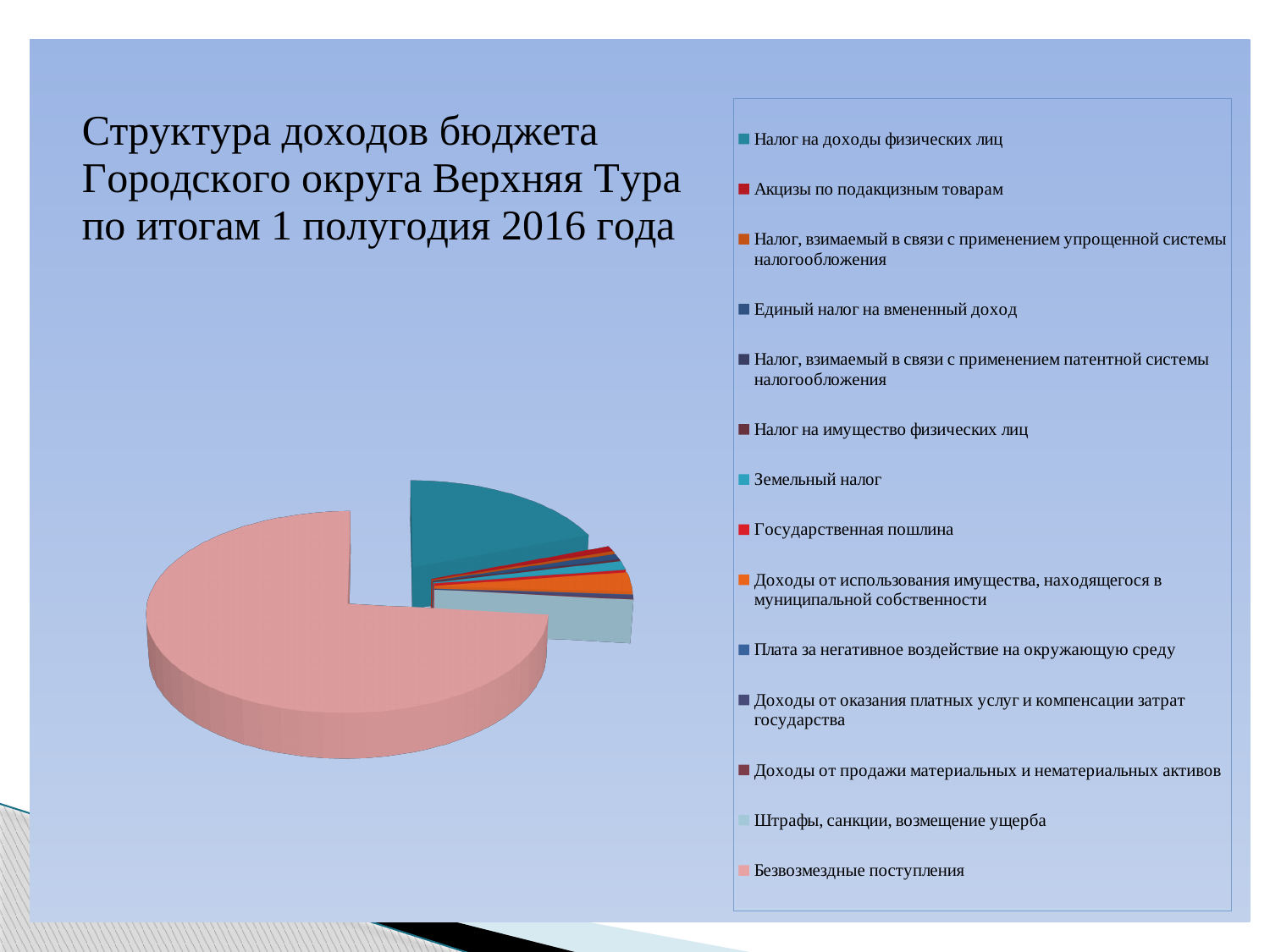
Which category has the largest slice of the pie chart? Безвозмездные поступления Which category has the second-largest slice of the pie chart? Налог на доходы физических лиц What kind of chart is shown on the slide? Pie chart Which is larger in the pie chart: Безвозмездные поступления or Налог на доходы физических лиц? Безвозмездные поступления Which is larger in the pie chart: Налог на доходы физических лиц or Земельный налог? Налог на доходы физических лиц How many categories does the legend of the pie chart list? 14 What is the title of the slide containing the pie chart? Структура доходов бюджета Городского округа Верхняя Тура по итогам 1 полугодия 2016 года What colour is the largest slice of the pie chart? Pink